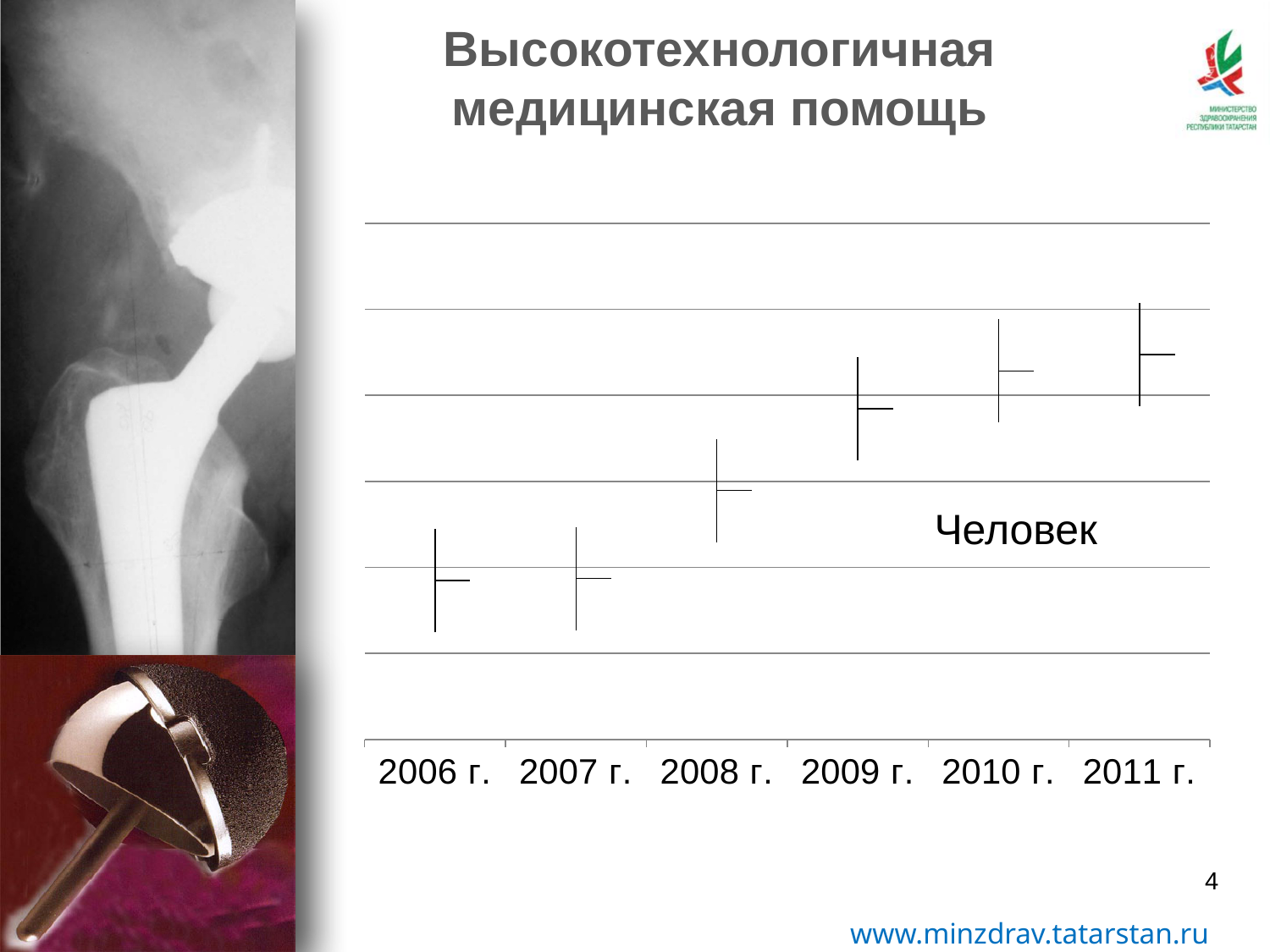
How many years are shown on the x axis of the chart? 6 What label is printed inside the chart area? Человек What is the title of the slide containing the chart? Высокотехнологичная медицинская помощь Which year has the highest value in the chart? 2011 г. Which is larger in the chart, the value for 2007 г. or the value for 2008 г.? 2008 г. What is the first year shown on the x axis of the chart? 2006 г. Do the values in the chart rise or fall from 2006 г. to 2011 г.? rise Which is larger in the chart, the value for 2006 г. or the value for 2011 г.? 2011 г. Which is larger in the chart, the value for 2008 г. or the value for 2009 г.? 2009 г.